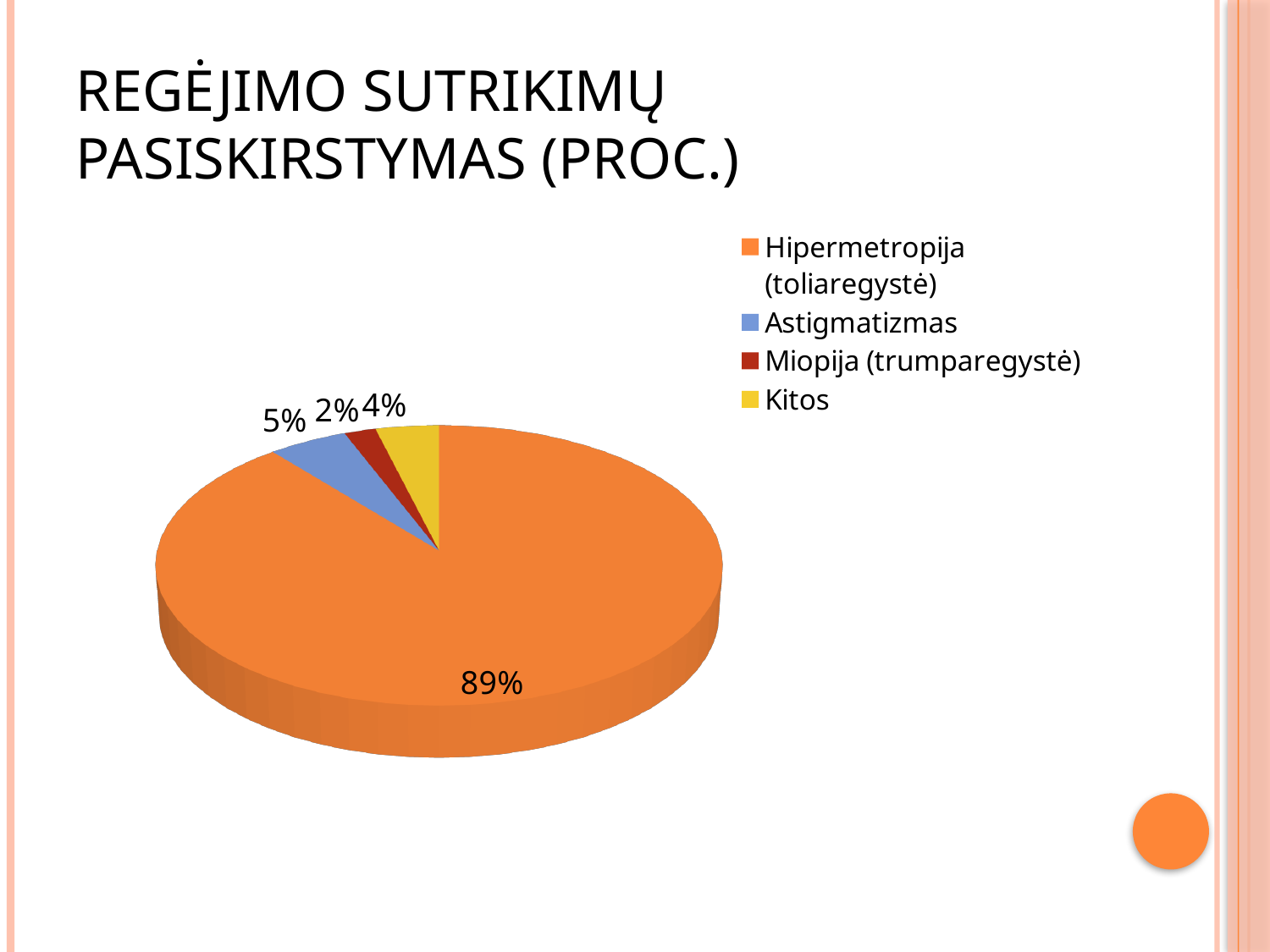
Which is larger, the share for Astigmatizmas or the share for Kitos? Astigmatizmas What kind of chart is shown on the slide? pie chart How many categories does the pie chart show? 4 Which category has the smallest slice of the pie? Miopija (trumparegystė) What is the title of the chart on the slide? Regėjimo sutrikimų pasiskirstymas (proc.) What share of the pie does Astigmatizmas have? 5% What share of the pie does Kitos have? 4% What colour is the slice for Kitos? yellow What share of the pie does Hipermetropija (toliaregystė) have? 89% Which category has the largest slice of the pie? Hipermetropija (toliaregystė) What is the difference in percentage points between Astigmatizmas and Kitos? 1%